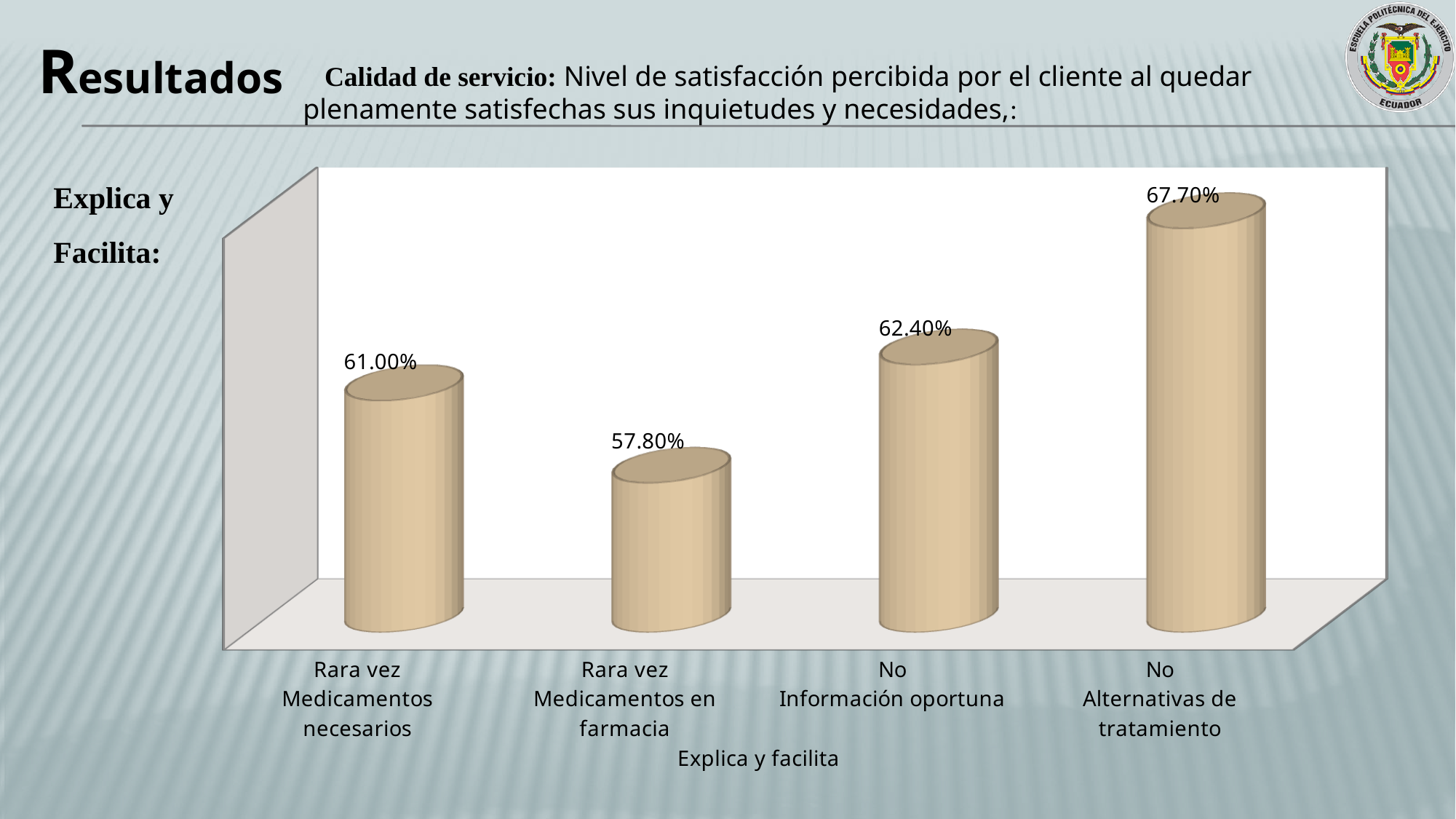
Which category has the lowest value? Rara vez Medicamentos en farmacia How many categories are shown in the chart? 4 What is the value for 'No Alternativas de tratamiento'? 67.70% What is the value for 'Rara vez Medicamentos en farmacia'? 57.80% What is the difference between the values for 'No Alternativas de tratamiento' and 'Rara vez Medicamentos en farmacia'? 9.90% What is the value for 'No Información oportuna'? 62.40% What is the x-axis title of the chart? Explica y facilita What is the value for 'Rara vez Medicamentos necesarios'? 61.00% What kind of chart is shown on the slide? Bar chart What is the difference between the values for 'No Información oportuna' and 'Rara vez Medicamentos necesarios'? 1.40% Which category has the highest value? No Alternativas de tratamiento Which is larger, the value for 'Rara vez Medicamentos necesarios' or 'Rara vez Medicamentos en farmacia'? Rara vez Medicamentos necesarios